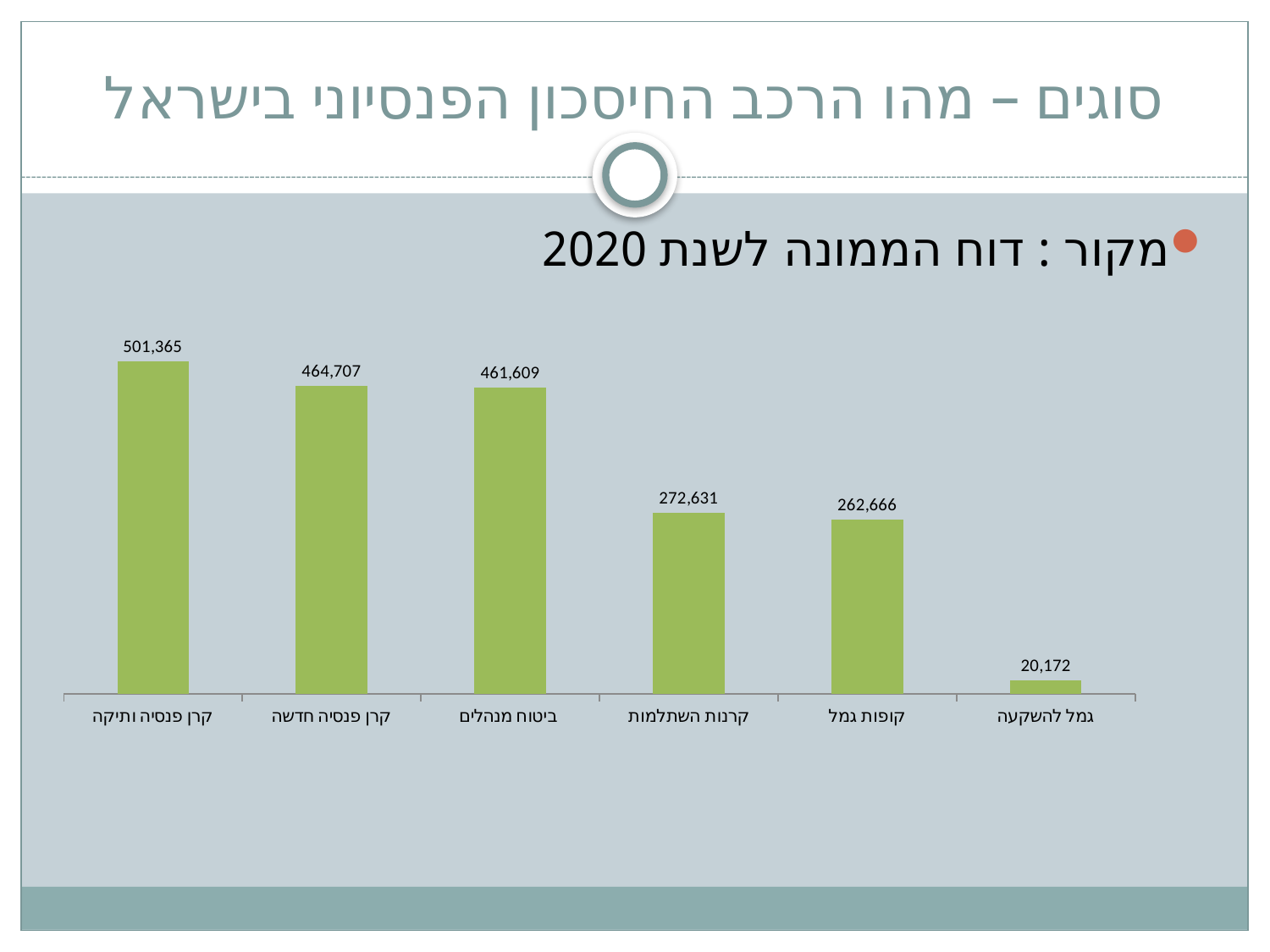
What is the value for ביטוח מנהלים? 461,609 What kind of chart is shown on the slide? Bar chart What is the difference between the values for קרן פנסיה ותיקה and קרן פנסיה חדשה? 36,658 Which category has the lowest value? גמל להשקעה What is the value for גמל להשקעה? 20,172 How many categories are shown in the chart? 6 What is the value for קופות גמל? 262,666 Which is larger, the value for ביטוח מנהלים or the value for קרנות השתלמות? ביטוח מנהלים Do the values rise or fall moving from left to right across the chart? Fall What is the difference between the values for קרנות השתלמות and קופות גמל? 9,965 Which category has the highest value? קרן פנסיה ותיקה What is the value for קרן פנסיה ותיקה? 501,365